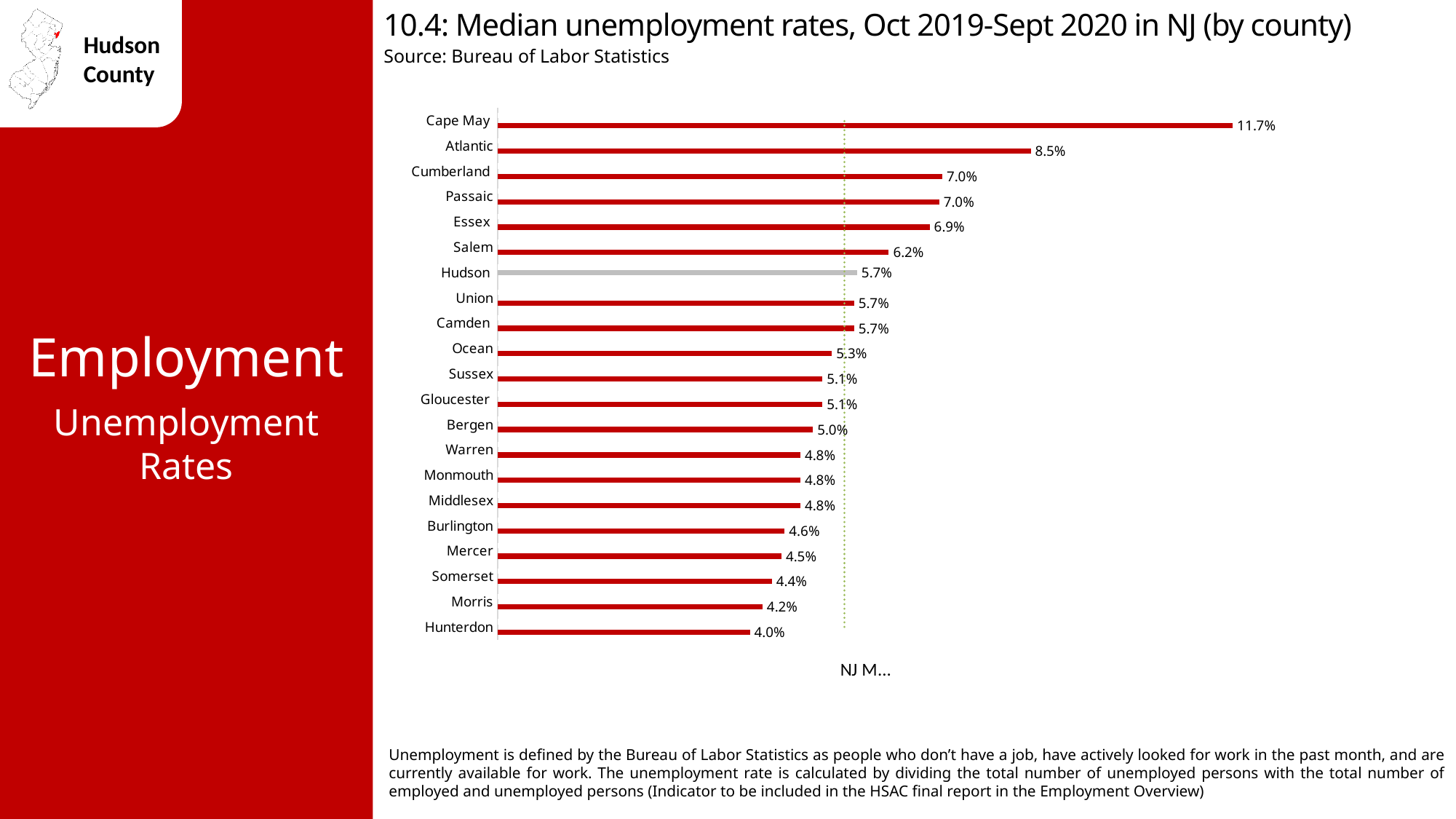
What is the median unemployment rate for Bergen? 5.0% Which county has the highest median unemployment rate? Cape May What is the median unemployment rate for Cape May? 11.7% What kind of chart is shown on the slide? Bar chart Which county has a higher median unemployment rate, Essex or Salem? Essex How many counties are shown in the chart? 21 What is the median unemployment rate for Hudson County? 5.7% Which county's bar is shown in grey rather than red? Hudson What is the difference between the median unemployment rates of Cape May and Atlantic? 3.2% Which county has the lowest median unemployment rate? Hunterdon What is the difference between the median unemployment rates of Hudson and Hunterdon? 1.7% What is the median unemployment rate for Hunterdon? 4.0%